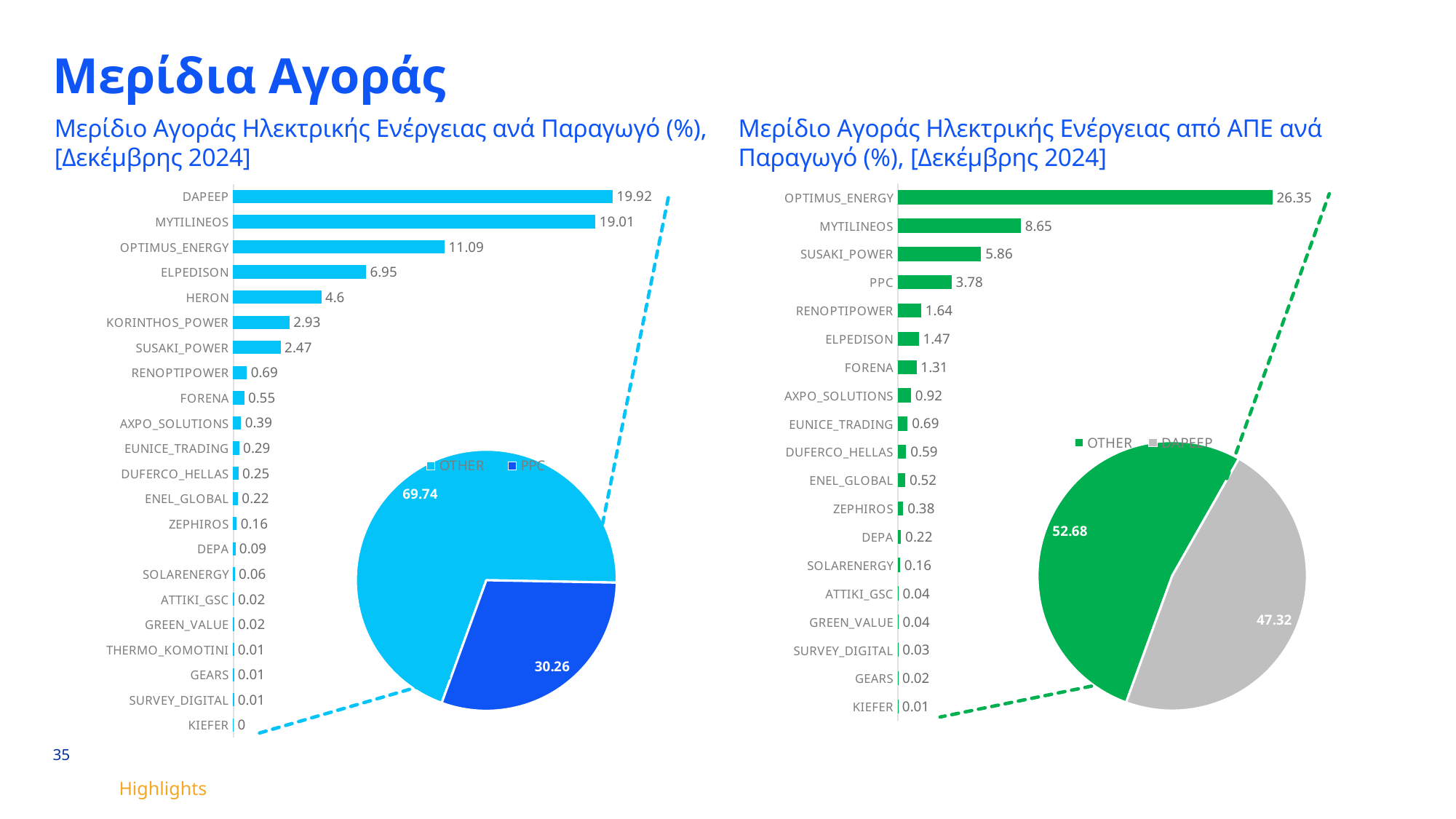
How many producers are listed in the left bar chart (market share per producer)? 22 In the left bar chart (market share per producer), what is the difference between DAPEEP and MYTILINEOS? 0.91 In the right bar chart (RES market share per producer), which producer has the highest value? OPTIMUS_ENERGY In the left bar chart (market share per producer), what is the value for DAPEEP? 19.92 What type of chart is used to show the market share per producer on the left side of the slide? Bar chart In the left pie chart, what share does PPC have? 30.26 In the right bar chart (RES market share per producer), which is larger, the value for PPC or the value for RENOPTIPOWER? PPC In the right bar chart (RES market share per producer), what is the value for SUSAKI_POWER? 5.86 In the left bar chart (market share per producer), what is the value for HERON? 4.6 How many entries does the legend of the right pie chart list? 2 In the right pie chart, what share does DAPEEP have? 47.32 How many producers are listed in the right bar chart (RES market share per producer)? 19